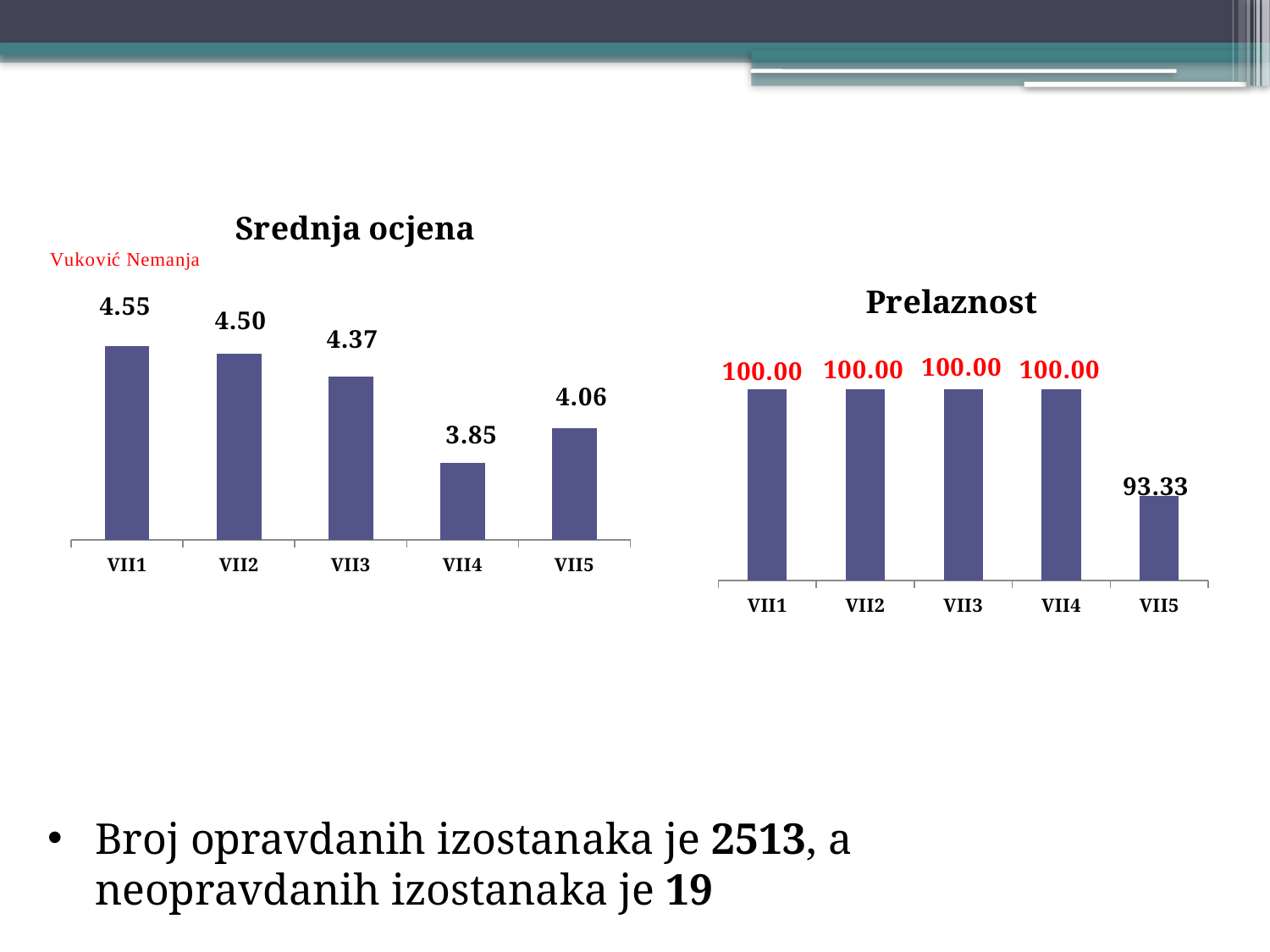
In the 'Srednja ocjena' chart, how many categories are shown? 5 In the 'Srednja ocjena' chart, which is larger, the value for VII3 or the value for VII5? VII3 In the 'Srednja ocjena' chart, which category has the lowest value? VII4 What kind of chart is the 'Prelaznost' chart? Bar chart In the 'Srednja ocjena' chart, what is the value for VII1? 4.55 In the 'Prelaznost' chart, which category has the lowest value? VII5 In the 'Srednja ocjena' chart, what is the difference between the values for VII1 and VII4? 0.70 In the 'Prelaznost' chart, what is the difference between the values for VII1 and VII5? 6.67 In the 'Prelaznost' chart, what is the value for VII2? 100.00 In the 'Prelaznost' chart, what is the value for VII5? 93.33 In the 'Srednja ocjena' chart, what is the value for VII4? 3.85 In the 'Srednja ocjena' chart, which category has the highest value? VII1